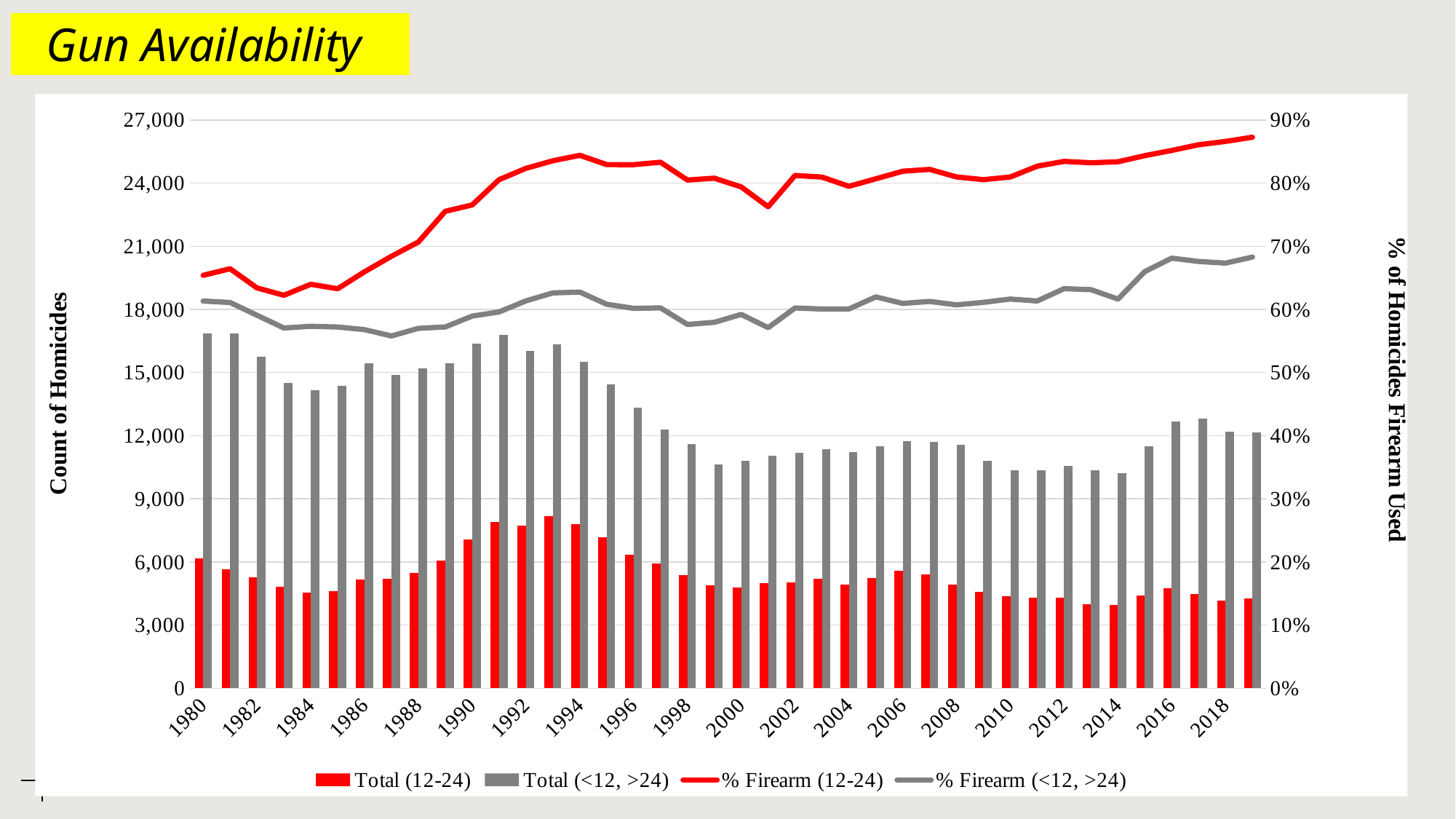
How many series does the legend list? 4 How many years are plotted along the x axis? 40 Is the value for % Firearm (<12, >24) in 1984 greater or less than 60%? less Is the value for Total (<12, >24) in 2014 greater or less than 12,000? less Does the Total (<12, >24) series rise or fall from 1991 to 2000? Fall Which is larger, Total (<12, >24) in 1991 or Total (<12, >24) in 2000? 1991 What is the title of the left vertical axis? Count of Homicides Is the value for Total (12-24) in 1993 greater or less than 9,000? less What kind of chart is shown on the slide? A combined bar and line chart Which year has the highest value for % Firearm (12-24)? 2019